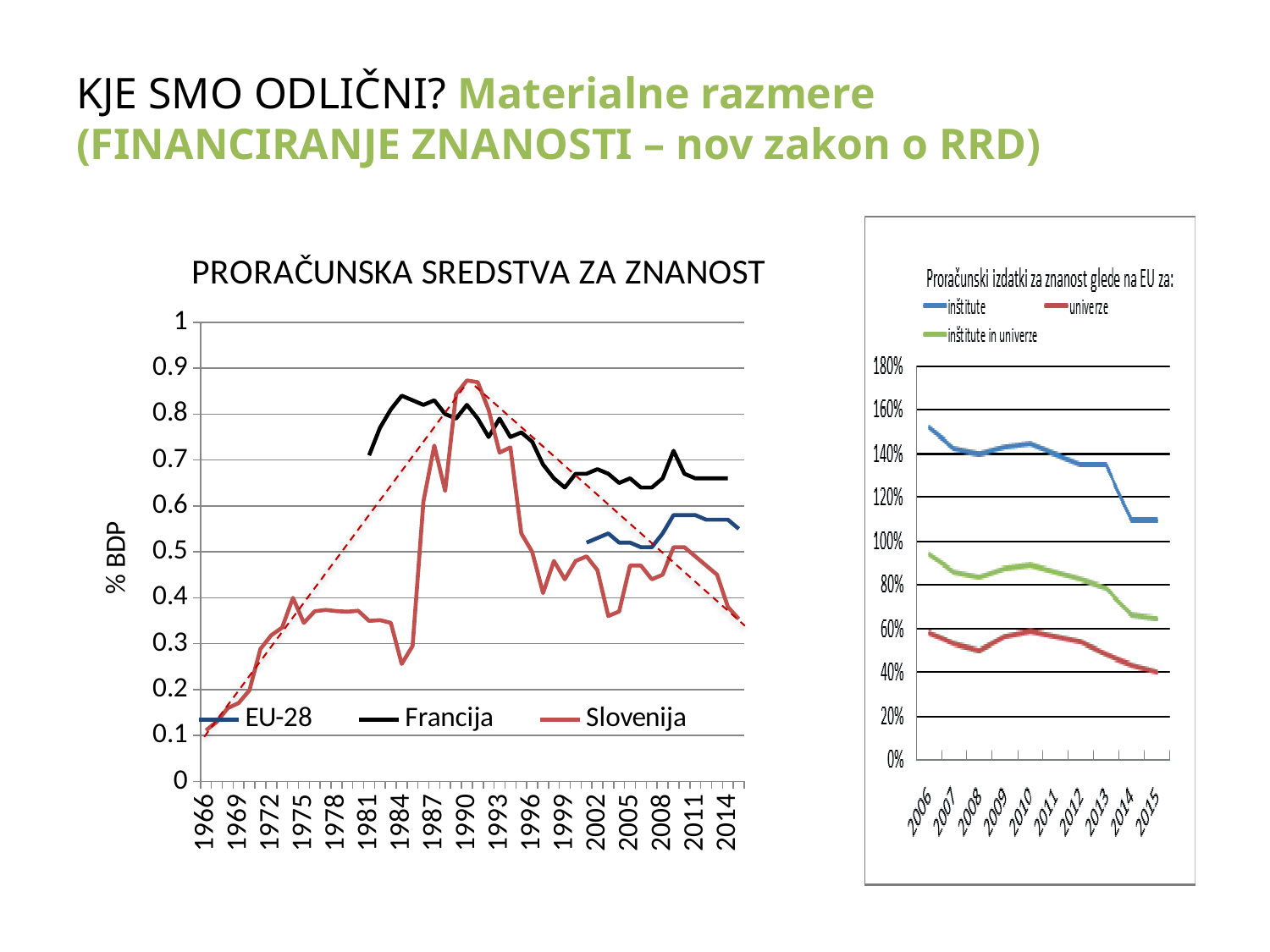
In the left chart "PRORAČUNSKA SREDSTVA ZA ZNANOST", is the value for Slovenija in 2014 greater or less than 0.5? less How many series does the legend of the left chart "PRORAČUNSKA SREDSTVA ZA ZNANOST" list? 3 How many series does the legend of the right chart "Proračunski izdatki za znanost glede na EU za:" list? 3 In the left chart "PRORAČUNSKA SREDSTVA ZA ZNANOST", is the value for Francija in 1984 greater or less than 0.8? greater In the right chart "Proračunski izdatki za znanost glede na EU za:", does the inštitute series rise or fall from 2006 to 2015? fall In the left chart "PRORAČUNSKA SREDSTVA ZA ZNANOST", which is higher in 2011, Francija or EU-28? Francija In the right chart "Proračunski izdatki za znanost glede na EU za:", which series has the lowest value in 2006? univerze What kind of chart is the left chart titled "PRORAČUNSKA SREDSTVA ZA ZNANOST"? line chart How many years are shown on the x axis of the right chart "Proračunski izdatki za znanost glede na EU za:"? 10 In the right chart "Proračunski izdatki za znanost glede na EU za:", is the value for univerze in 2015 greater or less than 60%? less In the right chart "Proračunski izdatki za znanost glede na EU za:", which series has the highest value in 2015? inštitute